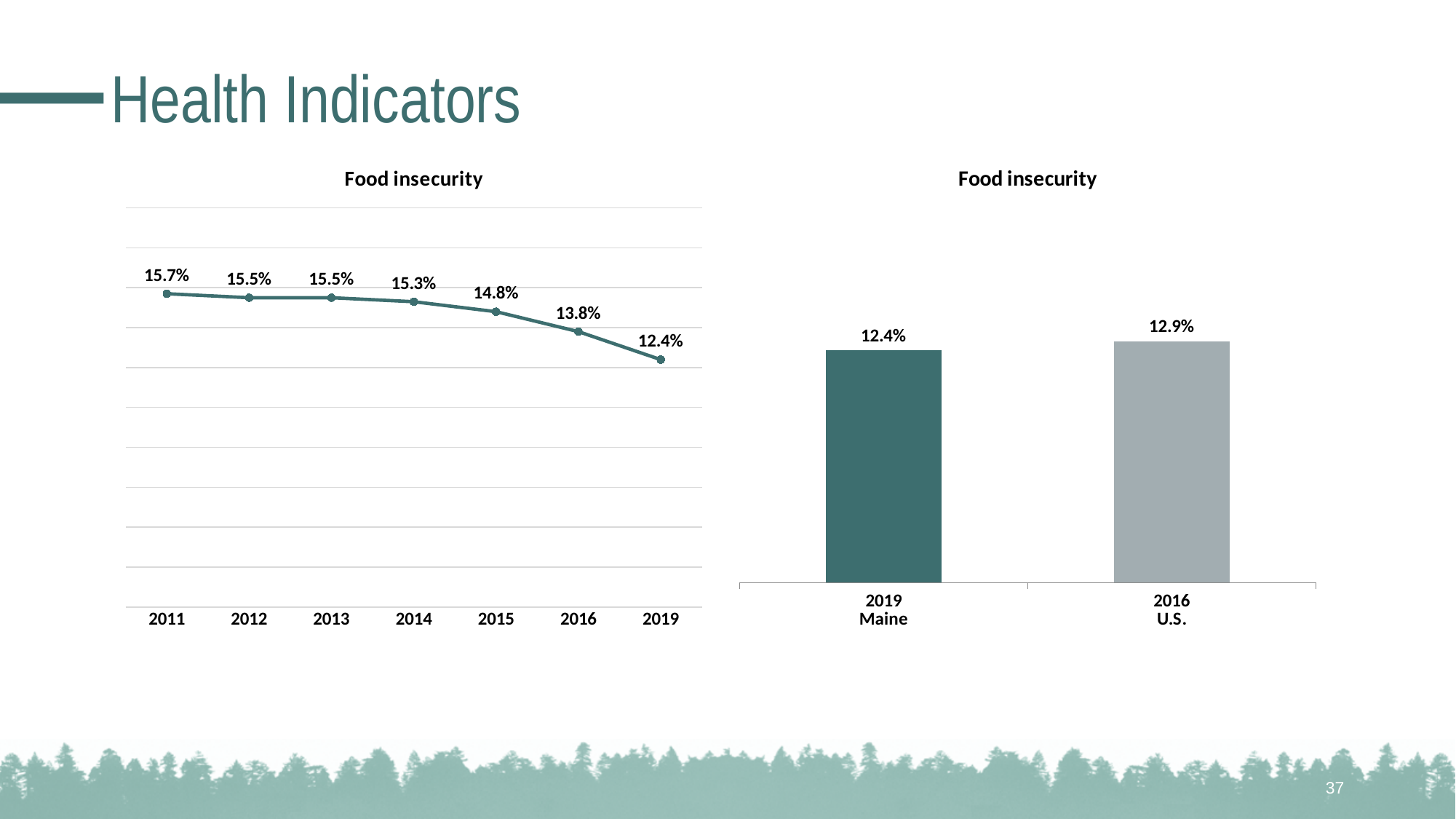
What kind of chart is the left-hand Food insecurity chart? line chart How many data points are plotted in the left-hand Food insecurity chart? 7 In the left-hand Food insecurity chart, do the values rise or fall from 2011 to 2019? fall In the left-hand Food insecurity chart, what is the value for 2015? 14.8% In the left-hand Food insecurity chart, what is the value for 2011? 15.7% In the left-hand Food insecurity chart, which year has the lowest value? 2019 In the left-hand Food insecurity chart, what is the value for 2019? 12.4% In the right-hand Food insecurity chart, which is larger, the 2019 Maine value or the 2016 U.S. value? 2016 U.S. In the right-hand Food insecurity chart, what is the value for 2016 U.S.? 12.9% In the left-hand Food insecurity chart, what is the difference between the 2011 value and the 2019 value? 3.3% What kind of chart is the right-hand Food insecurity chart? bar chart In the left-hand Food insecurity chart, which year has the highest value? 2011